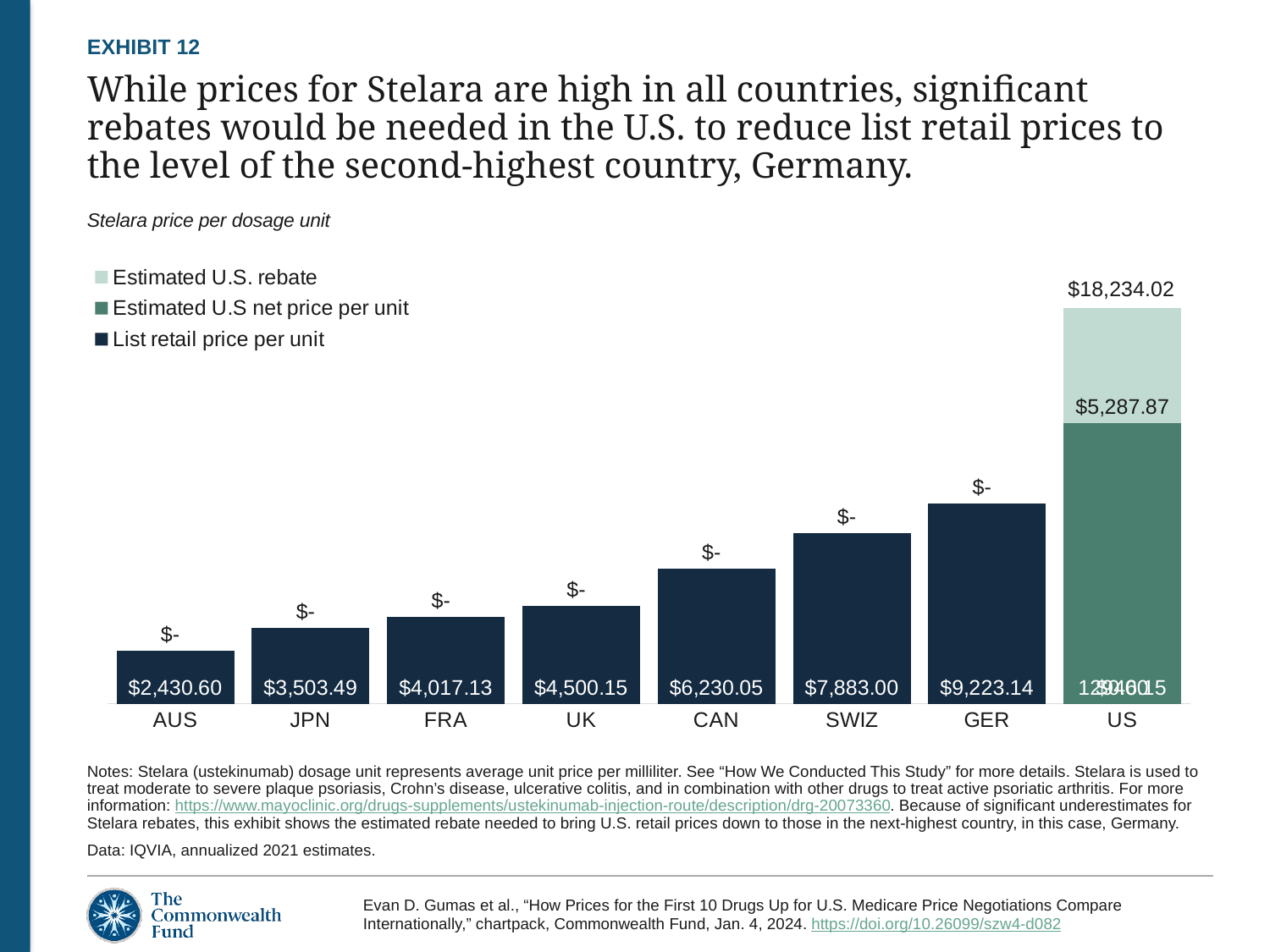
What is the difference between the list retail price per unit for GER and SWIZ? $1,340.14 What is the list retail price per unit for AUS? $2,430.60 What kind of chart is shown on the slide? Stacked bar chart What is the estimated U.S. net price per unit shown for the US bar? $12,946.15 How many countries are shown on the x axis? 8 Which country has the tallest bar overall? US What is the list retail price per unit for GER? $9,223.14 Which country has the lowest list retail price per unit? AUS Which has a higher list retail price per unit, CAN or UK? CAN What is the estimated U.S. rebate shown for the US bar? $5,287.87 How many series does the legend list? 3 What is the difference between the list retail price per unit for JPN and AUS? $1,072.89